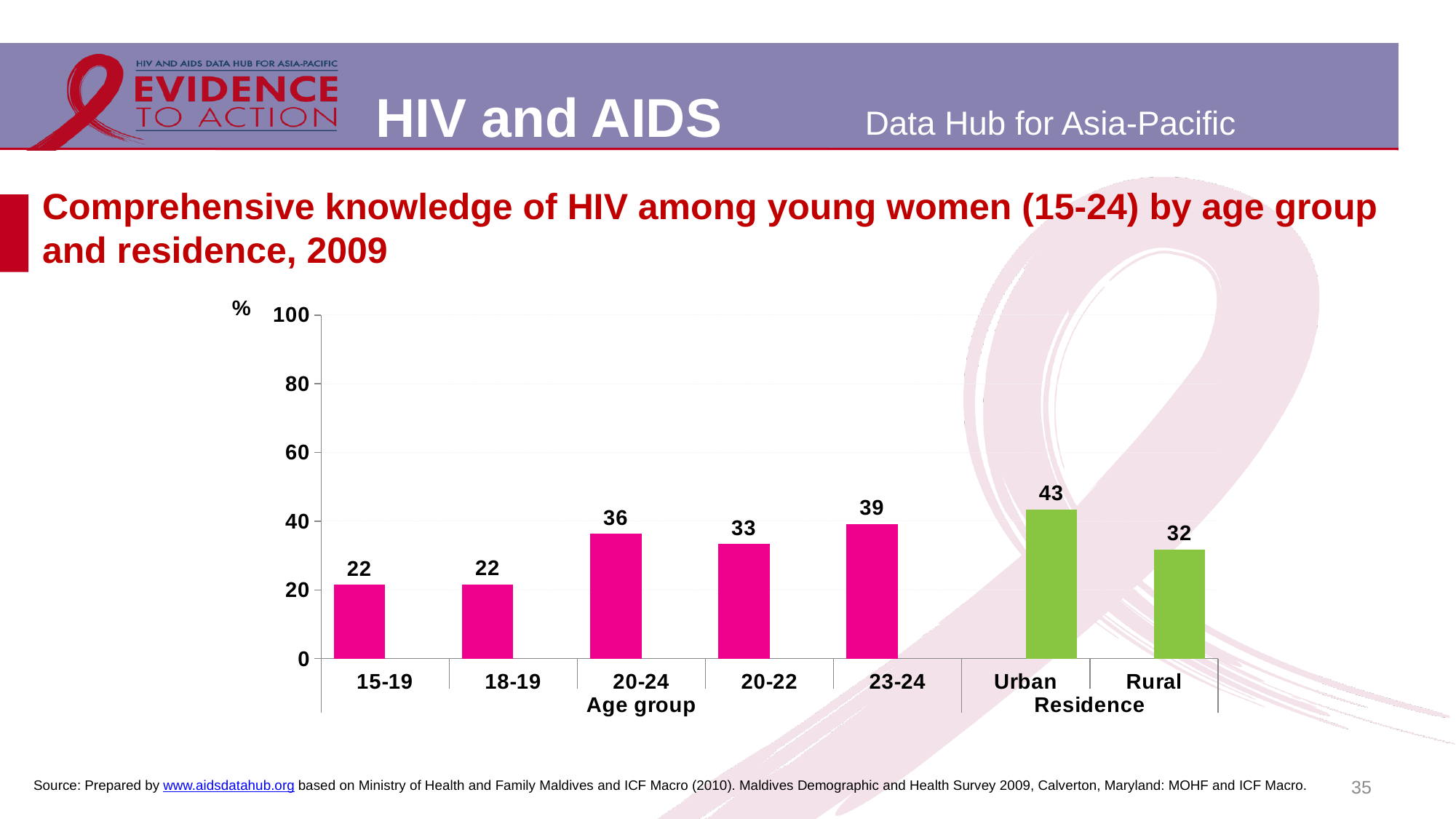
What is the value for Urban residence? 43 What unit is shown on the vertical axis? % What is the difference between the Urban and Rural values? 11 Which category has the highest value? Urban What is the value for the 20-24 age group? 36 What is the value for the 23-24 age group? 39 Which age group has the lowest value among the age groups 20-24, 20-22 and 23-24? 20-22 What is the difference between the 23-24 and 15-19 values? 17 Which is larger, the value for 20-22 or the value for 23-24? 23-24 Is the value for Urban greater or less than 40? greater How many bars are plotted on the chart? 7 What kind of chart is shown on the slide? Bar chart